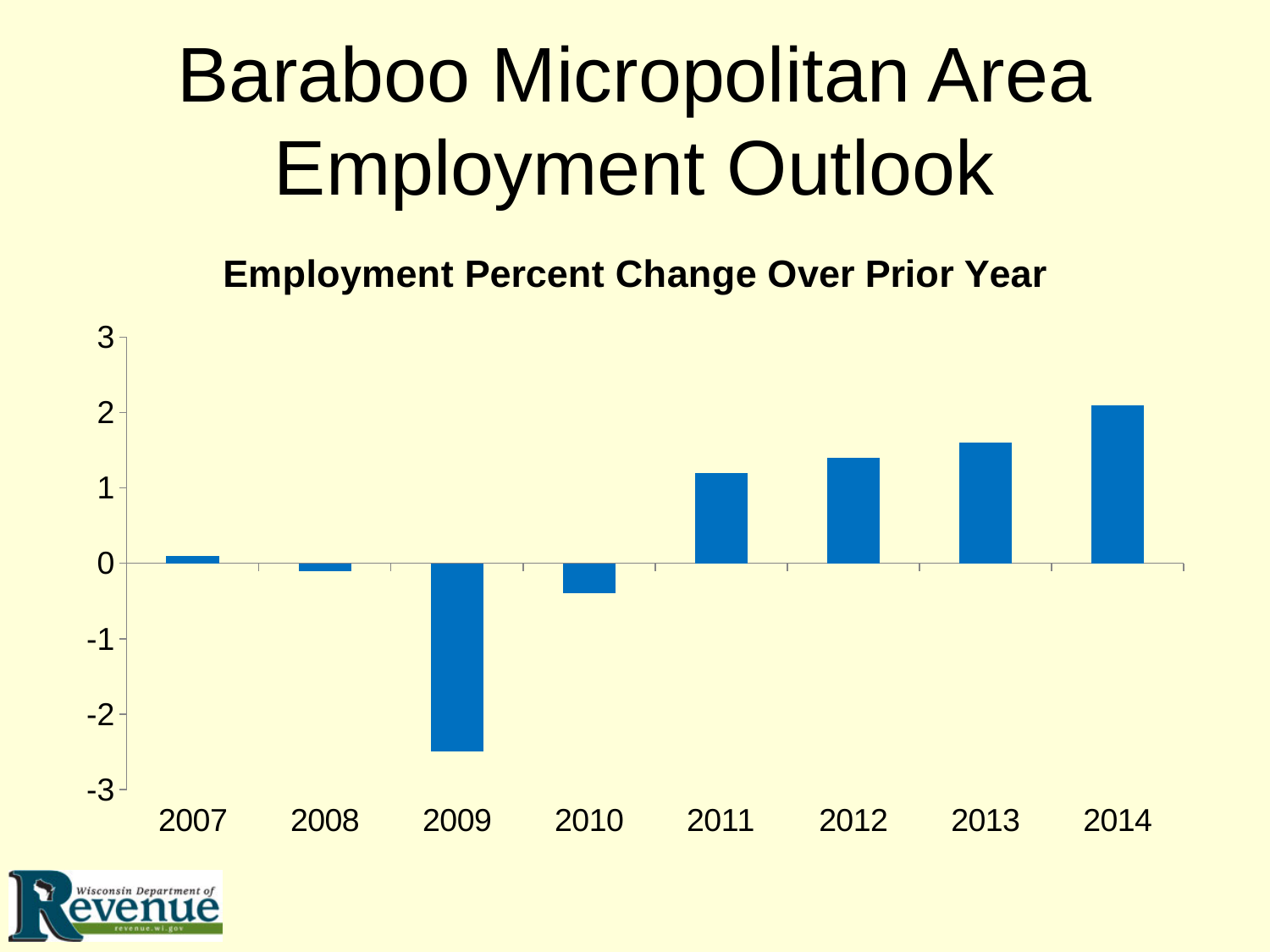
What is the title of the chart? Employment Percent Change Over Prior Year Which year has the larger employment percent change, 2011 or 2013? 2013 What kind of chart is shown on the slide? bar chart Which year has the larger employment percent change, 2009 or 2010? 2010 Which year has the highest employment percent change? 2014 How many years are shown on the x axis of the chart? 8 Is the value for 2012 greater or less than 2? less Which year has the lowest employment percent change? 2009 Is the value for 2010 greater or less than -1? greater Do the values rise or fall from 2011 to 2014? rise Is the value for 2009 greater or less than -2? less